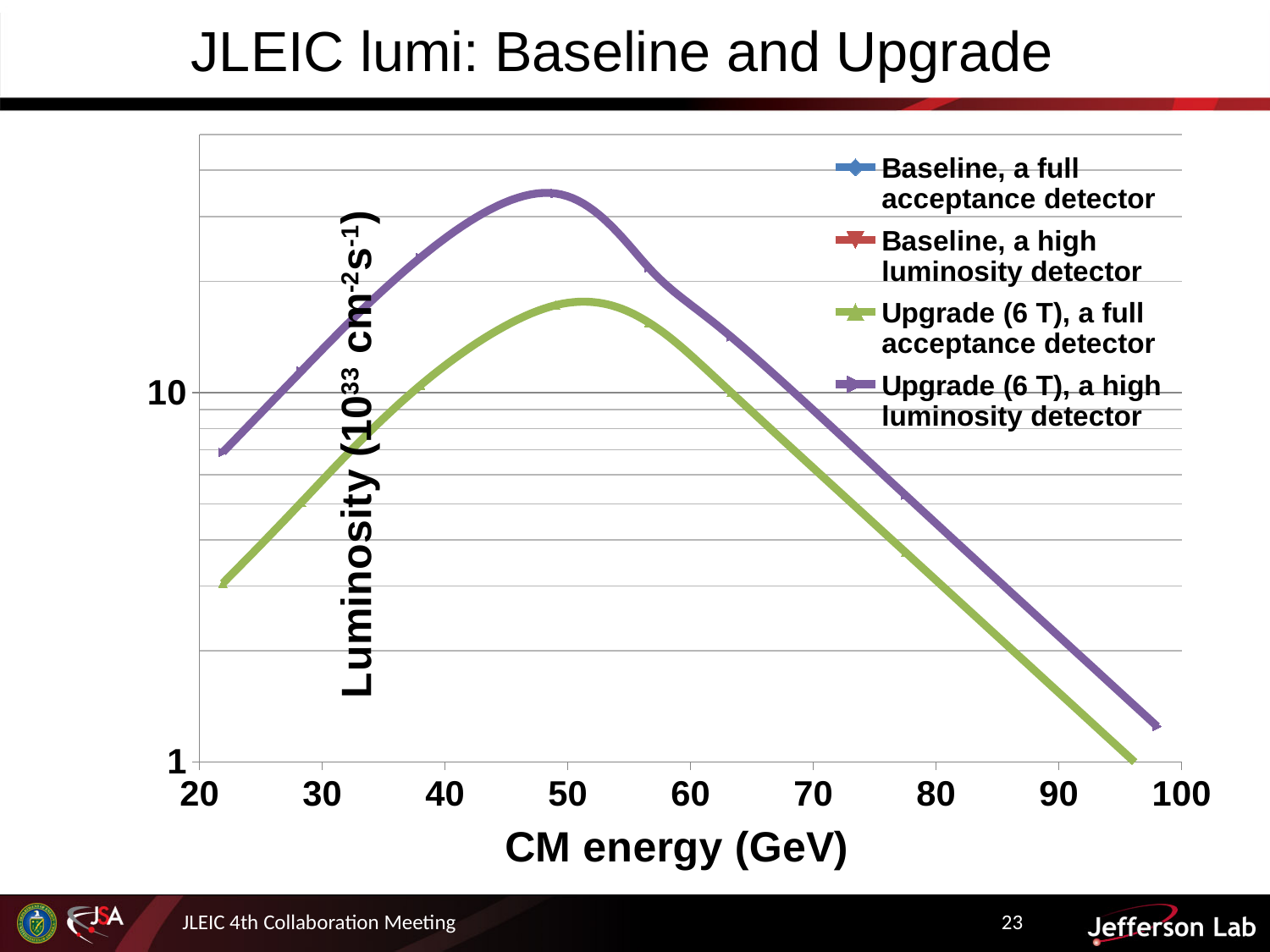
Do the plotted luminosity curves rise or fall as CM energy increases from 20 GeV to 45 GeV? rise Is the luminosity of the 'Upgrade (6 T), a high luminosity detector' curve at 22 GeV greater or less than 10? less How many series does the legend list? 4 At 50 GeV, which curve has the higher luminosity: 'Upgrade (6 T), a high luminosity detector' or 'Upgrade (6 T), a full acceptance detector'? Upgrade (6 T), a high luminosity detector Is the peak luminosity of the 'Upgrade (6 T), a high luminosity detector' curve greater or less than 10? greater What is the x-axis title of the chart? CM energy (GeV) Do the plotted luminosity curves rise or fall as CM energy increases from 60 GeV to 100 GeV? fall Is the peak luminosity of the 'Upgrade (6 T), a full acceptance detector' curve greater or less than 10? greater What kind of chart is shown on the slide? line chart Which plotted curve reaches the highest luminosity? Upgrade (6 T), a high luminosity detector What is the title of the chart on the slide? JLEIC lumi: Baseline and Upgrade